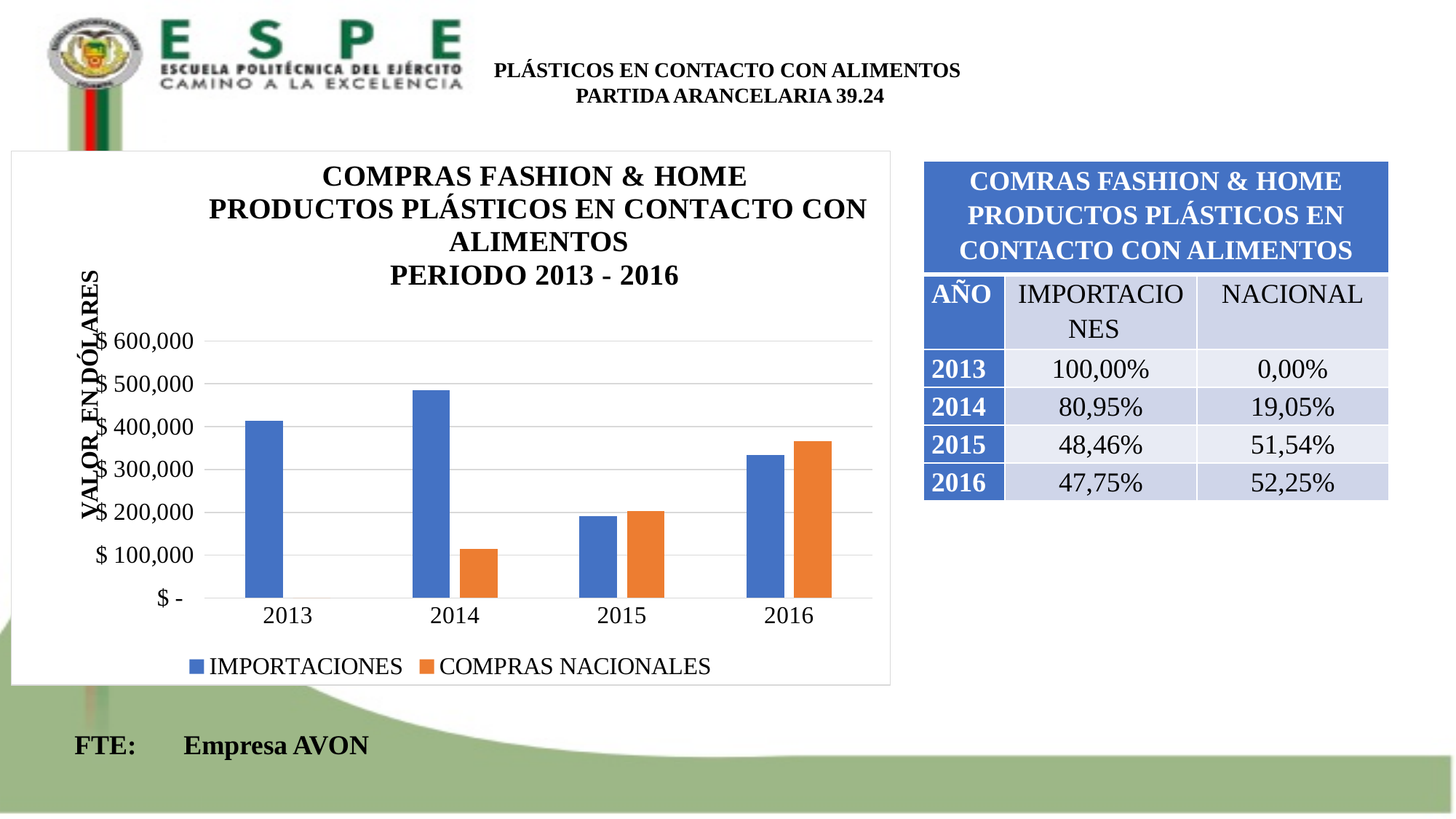
Is the COMPRAS NACIONALES value for 2016 greater or less than $ 300,000? greater Is the COMPRAS NACIONALES value for 2015 greater or less than $ 100,000? greater What is the title of the chart's vertical axis? VALOR EN DÓLARES In which year is the IMPORTACIONES bar lowest? 2015 Is the IMPORTACIONES value for 2014 greater or less than $ 400,000? greater What kind of chart is shown on the slide? bar chart In 2014, which is larger: IMPORTACIONES or COMPRAS NACIONALES? IMPORTACIONES How many years are shown on the x axis of the chart? 4 In which year is the IMPORTACIONES bar highest? 2014 Do the COMPRAS NACIONALES values rise or fall from 2013 to 2016? rise In which year is the COMPRAS NACIONALES bar highest? 2016 How many series does the chart legend list? 2